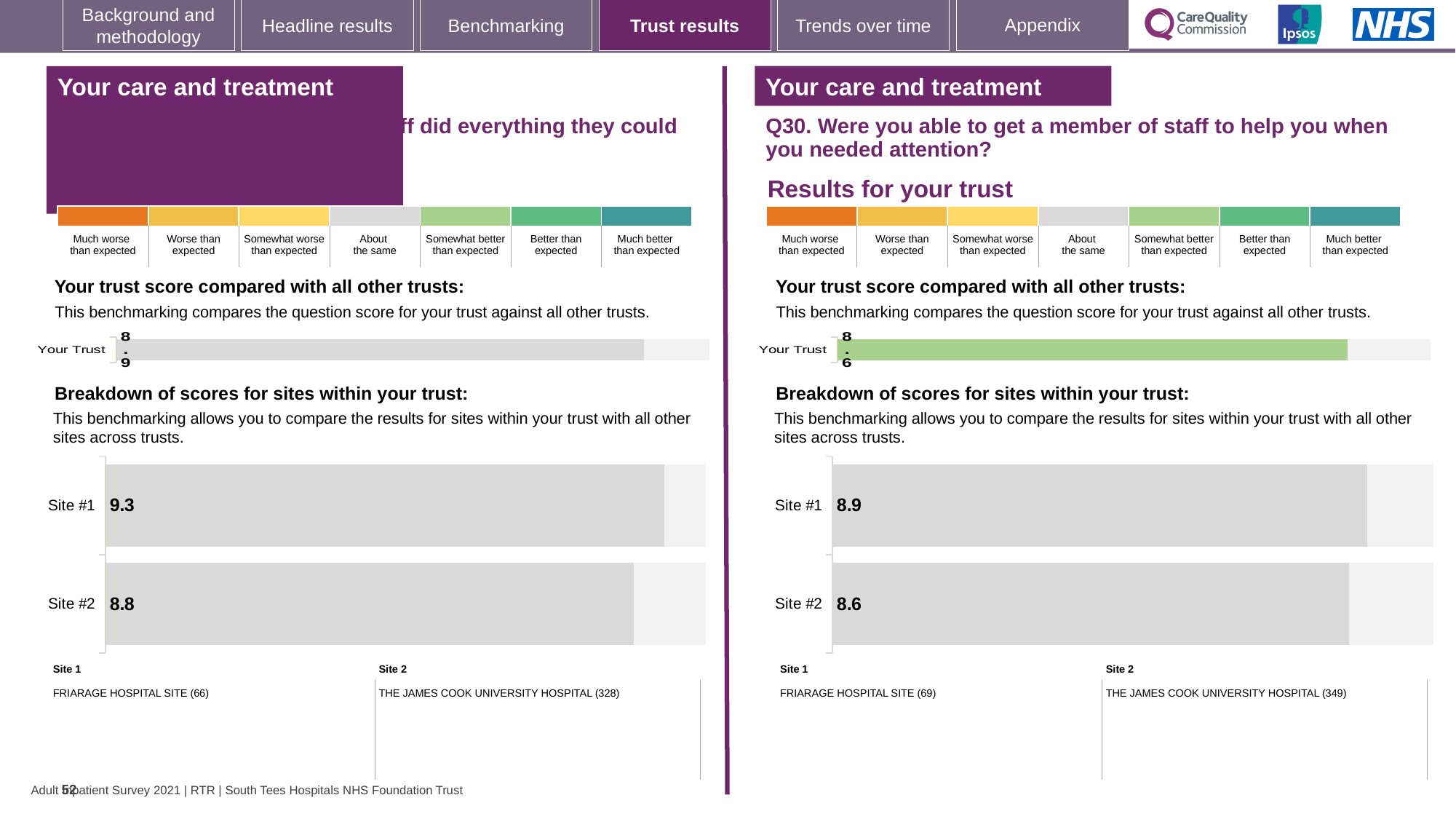
On the left-hand chart, what is the 'Your Trust' score? 8.9 On the right-hand chart (Q30), what is the difference between the Site #1 and Site #2 scores? 0.3 On the right-hand chart (Q30), what is the score for Site #1? 8.9 How many sites are shown in the site breakdown chart on the right-hand side (Q30)? 2 On the left-hand chart, what is the score for Site #1? 9.3 On the right-hand chart (Q30), what is the score for Site #2? 8.6 On the right-hand chart (Q30), what is the 'Your Trust' score? 8.6 On the left-hand chart, what is the difference between the Site #1 and Site #2 scores? 0.5 On the left-hand chart, which site has the higher score? Site #1 On the left-hand chart, what is the score for Site #2? 8.8 What type of chart is used for the breakdown of scores for sites on the right-hand side (Q30)? Bar chart On the right-hand chart (Q30), which site has the lower score? Site #2